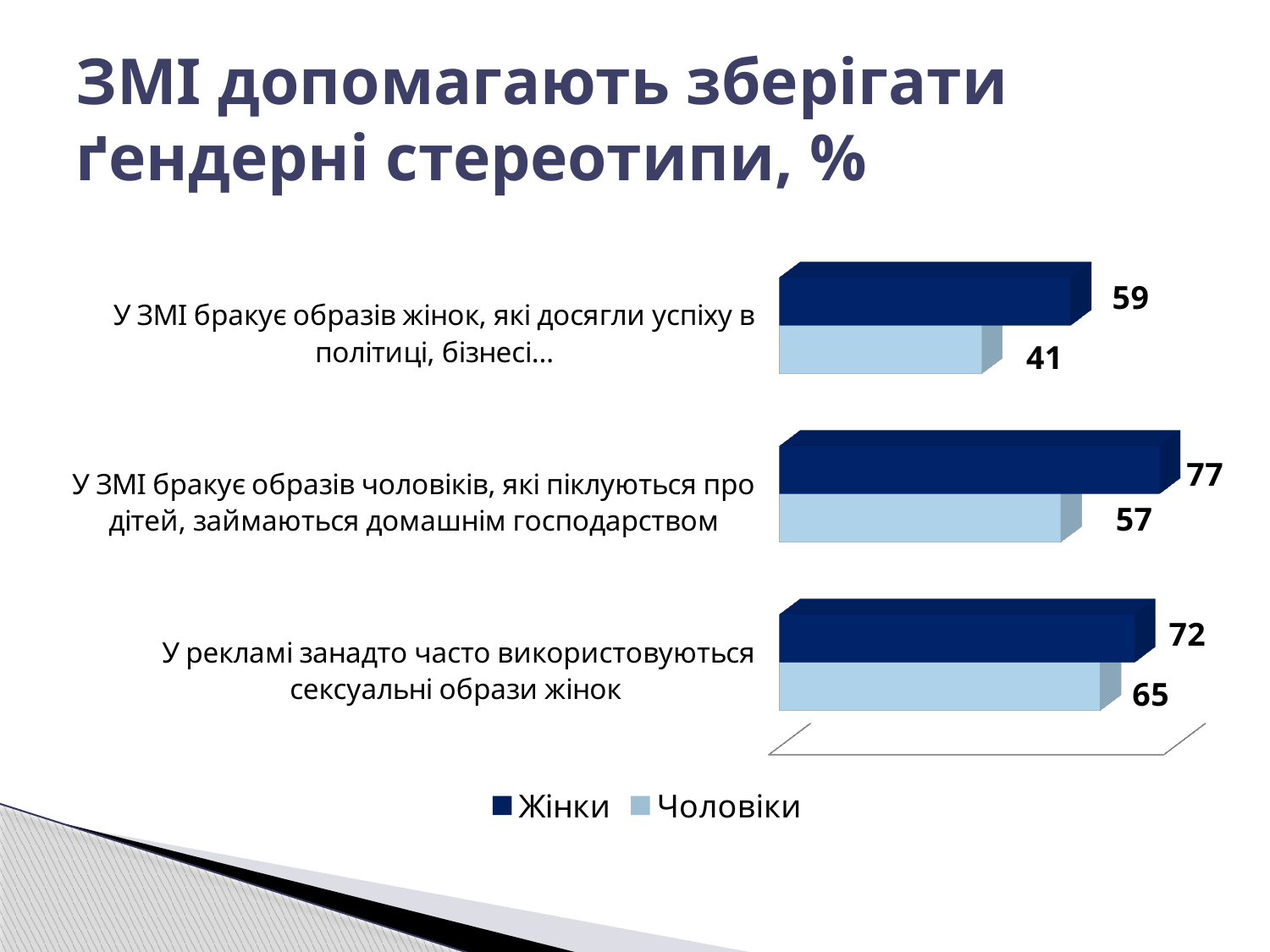
What is the value for Чоловіки for the category 'У рекламі занадто часто використовуються сексуальні образи жінок'? 65 What type of chart is shown on the slide? bar chart How many series does the legend list? 2 How many categories are plotted in the chart? 3 For the category 'У рекламі занадто часто використовуються сексуальні образи жінок', which series has the larger value, Жінки or Чоловіки? Жінки What is the difference between the Жінки values for 'У ЗМІ бракує образів чоловіків, які піклуються про дітей, займаються домашнім господарством' and 'У рекламі занадто часто використовуються сексуальні образи жінок'? 5 What is the difference between the Жінки and Чоловіки values for the category 'У ЗМІ бракує образів жінок, які досягли успіху в політиці, бізнесі…'? 18 Which category has the lowest value for Чоловіки? У ЗМІ бракує образів жінок, які досягли успіху в політиці, бізнесі… Which category has the highest value for Жінки? У ЗМІ бракує образів чоловіків, які піклуються про дітей, займаються домашнім господарством What is the value for Жінки for the category 'У ЗМІ бракує образів жінок, які досягли успіху в політиці, бізнесі…'? 59 What is the title of the chart on the slide? ЗМІ допомагають зберігати ґендерні стереотипи, % What is the value for Чоловіки for the category 'У ЗМІ бракує образів чоловіків, які піклуються про дітей, займаються домашнім господарством'? 57